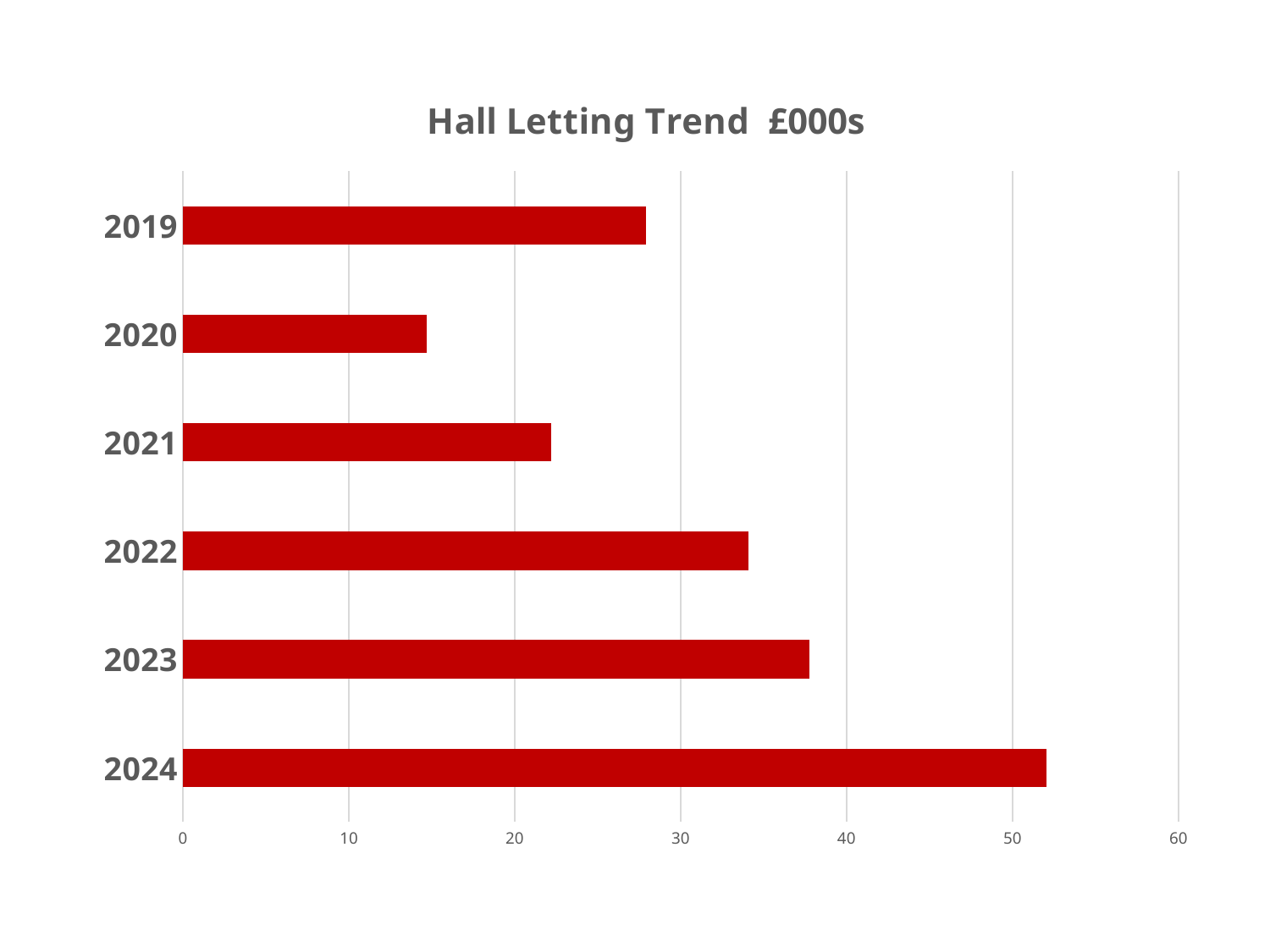
How many years are plotted in the chart? 6 What kind of chart is shown on the slide? bar chart Is the value for 2019 greater or less than 20? greater From 2021 to 2024, do the values rise or fall? rise What is the title of the chart? Hall Letting Trend £000s Is the value for 2022 greater or less than 30? greater Is the value for 2023 greater or less than 40? less Which year has the lowest value? 2020 Which is larger, the value for 2021 or the value for 2019? 2019 Which year has the highest value? 2024